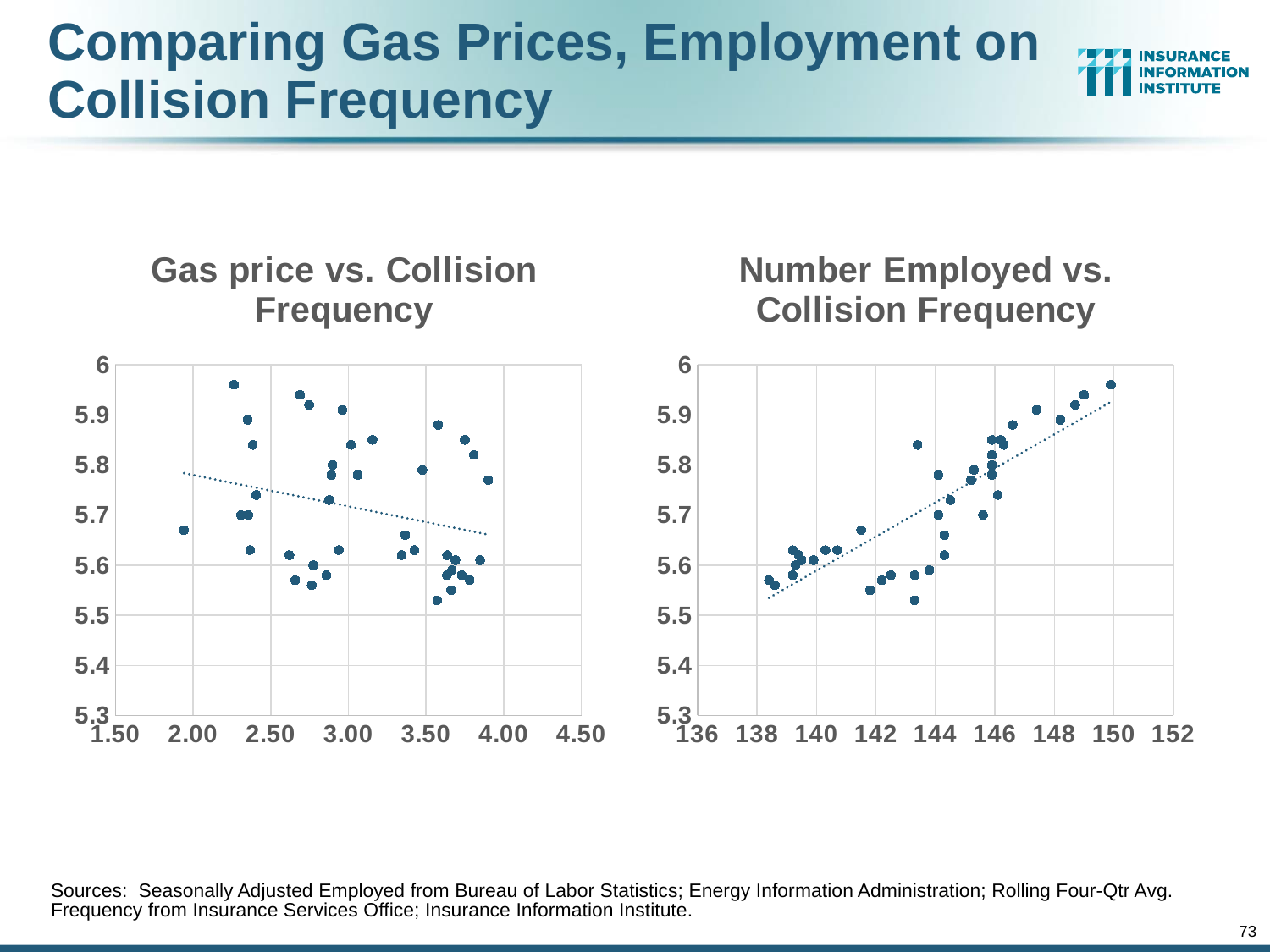
What is the title of the chart on the left side of the slide? Gas price vs. Collision Frequency What is the title of the chart on the right side of the slide? Number Employed vs. Collision Frequency In the 'Number Employed vs. Collision Frequency' chart, is the highest plotted collision frequency greater or less than 5.9? greater In the 'Number Employed vs. Collision Frequency' chart, does collision frequency rise or fall as the number employed increases along the x axis? rise Which chart shows a positive relationship between its x and y variables, the left chart or the right chart? the right chart In the 'Gas price vs. Collision Frequency' chart, does the dotted trend line rise or fall as gas price increases along the x axis? fall In the 'Gas price vs. Collision Frequency' chart, is the lowest plotted collision frequency greater or less than 5.6? less What kind of chart is the 'Gas price vs. Collision Frequency' chart on the left? scatter chart How many charts are shown on the slide? 2 What kind of chart is the 'Number Employed vs. Collision Frequency' chart on the right? scatter chart